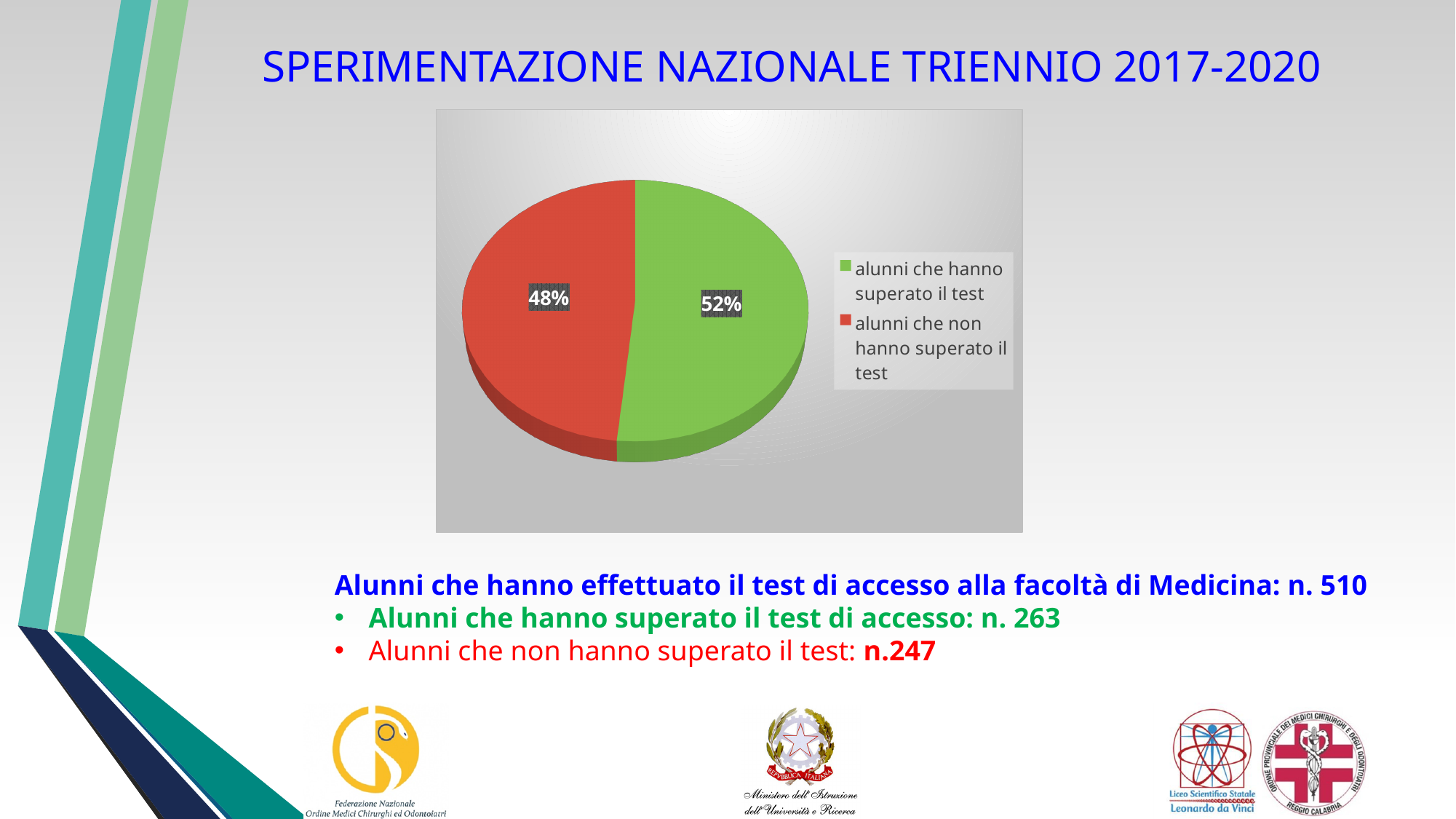
How many slices does the pie chart have? 2 What colour is the slice for "alunni che hanno superato il test"? green Which slice of the pie is the largest? alunni che hanno superato il test How many entries does the legend of the pie chart list? 2 Which slice is larger: "alunni che hanno superato il test" or "alunni che non hanno superato il test"? alunni che hanno superato il test Which slice of the pie is the smallest? alunni che non hanno superato il test What percentage of the pie is labelled for "alunni che hanno superato il test"? 52% What percentage of the pie is labelled for "alunni che non hanno superato il test"? 48% What kind of chart is shown on the slide? pie chart What colour is the slice for "alunni che non hanno superato il test"? red Is the share of the pie for "alunni che non hanno superato il test" greater or less than 50%? less What is the difference in percentage points between the two slices of the pie? 4%